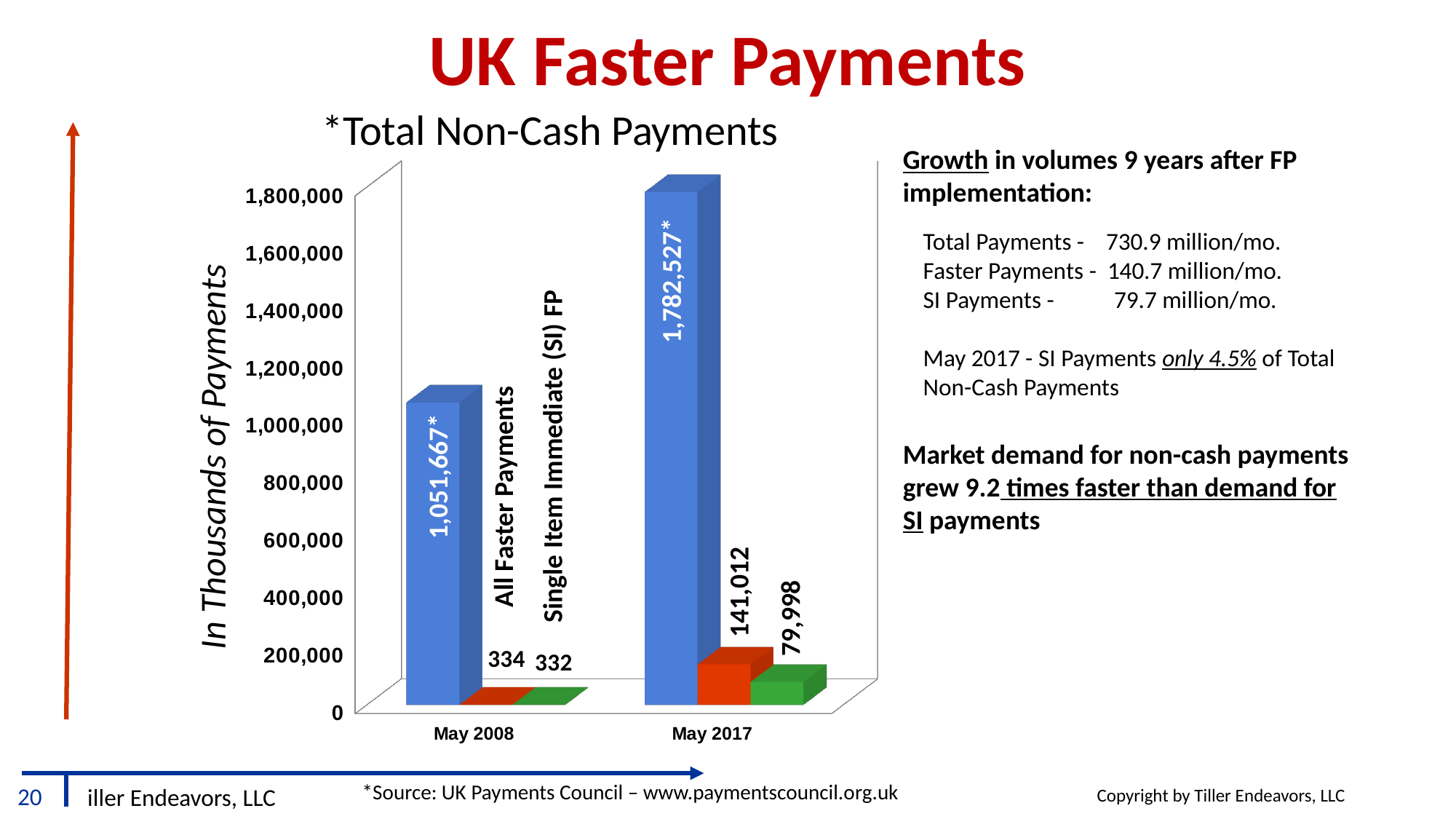
What is the value of Single Item Immediate (SI) FP for May 2008? 332 What type of chart is shown on the slide? Bar chart What is the value of Single Item Immediate (SI) FP for May 2017? 79,998 What is the value of Total Non-Cash Payments for May 2017? 1,782,527 How many time periods are shown on the x axis of the chart? 2 What is the value of Total Non-Cash Payments for May 2008? 1,051,667 Which is larger in May 2017: All Faster Payments or Single Item Immediate (SI) FP? All Faster Payments By how much did Total Non-Cash Payments increase from May 2008 to May 2017? 730,860 What is the value of All Faster Payments for May 2017? 141,012 What is the value of All Faster Payments for May 2008? 334 What is the label of the vertical axis of the chart? In Thousands of Payments What is the difference between All Faster Payments and Single Item Immediate (SI) FP in May 2017? 61,014